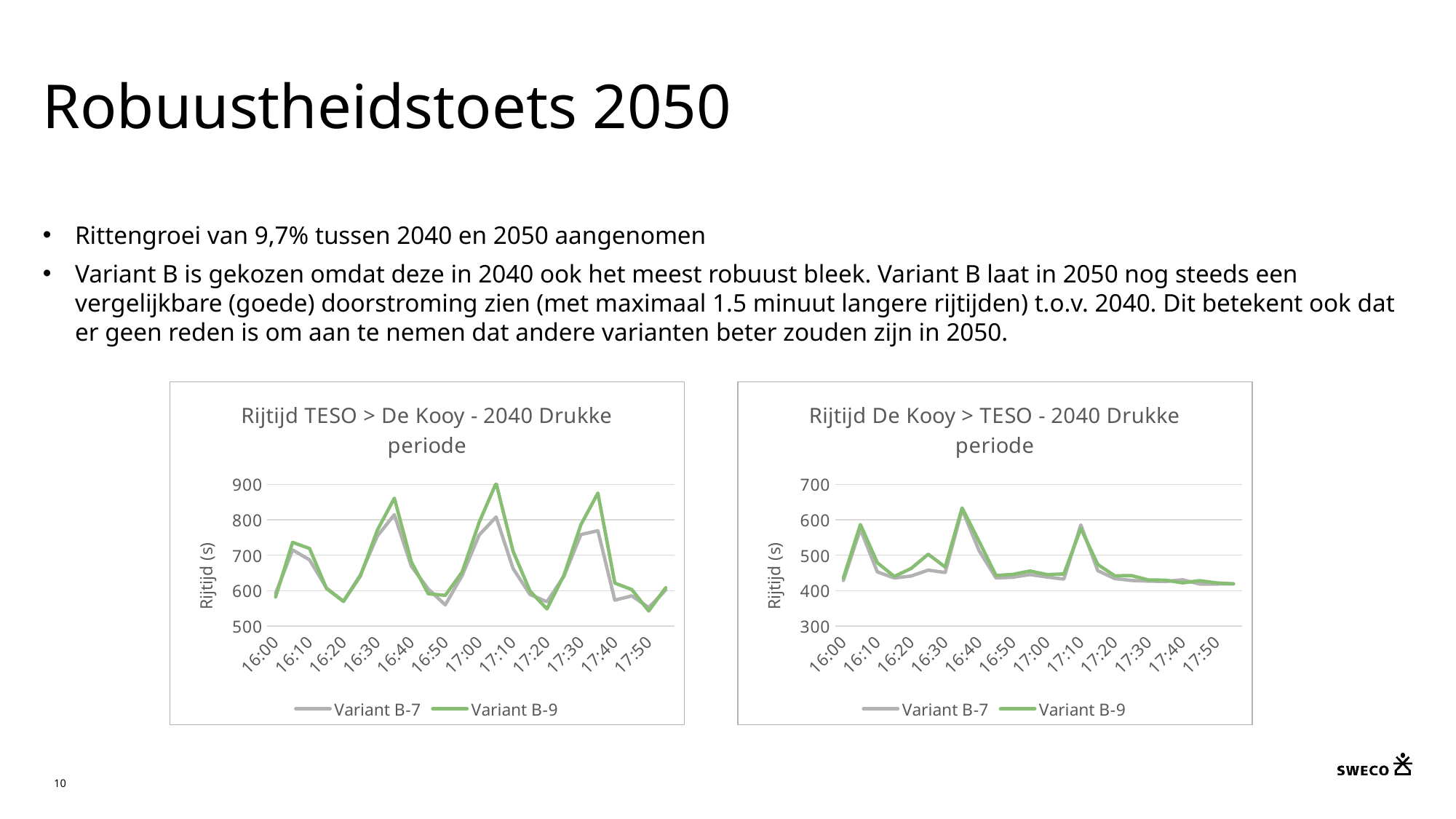
In the right chart, 'Rijtijd De Kooy > TESO - 2040 Drukke periode', is the value for Variant B-7 at 17:10 greater or less than 500? greater In the left chart, 'Rijtijd TESO > De Kooy - 2040 Drukke periode', which series has the larger value at 16:30, Variant B-7 or Variant B-9? Variant B-9 In the left chart, 'Rijtijd TESO > De Kooy - 2040 Drukke periode', is the value for Variant B-7 at 16:50 greater or less than 600? less In the left chart, 'Rijtijd TESO > De Kooy - 2040 Drukke periode', is the value for Variant B-9 at 16:30 greater or less than 800? less In the left chart, 'Rijtijd TESO > De Kooy - 2040 Drukke periode', which colour is used for the Variant B-9 line? green How many series does the legend of the right chart, 'Rijtijd De Kooy > TESO - 2040 Drukke periode', list? 2 What is the y-axis label of the right chart, 'Rijtijd De Kooy > TESO - 2040 Drukke periode'? Rijtijd (s) How many time points are shown on the x axis of the left chart, 'Rijtijd TESO > De Kooy - 2040 Drukke periode'? 12 What kind of chart is the left chart, 'Rijtijd TESO > De Kooy - 2040 Drukke periode'? line chart